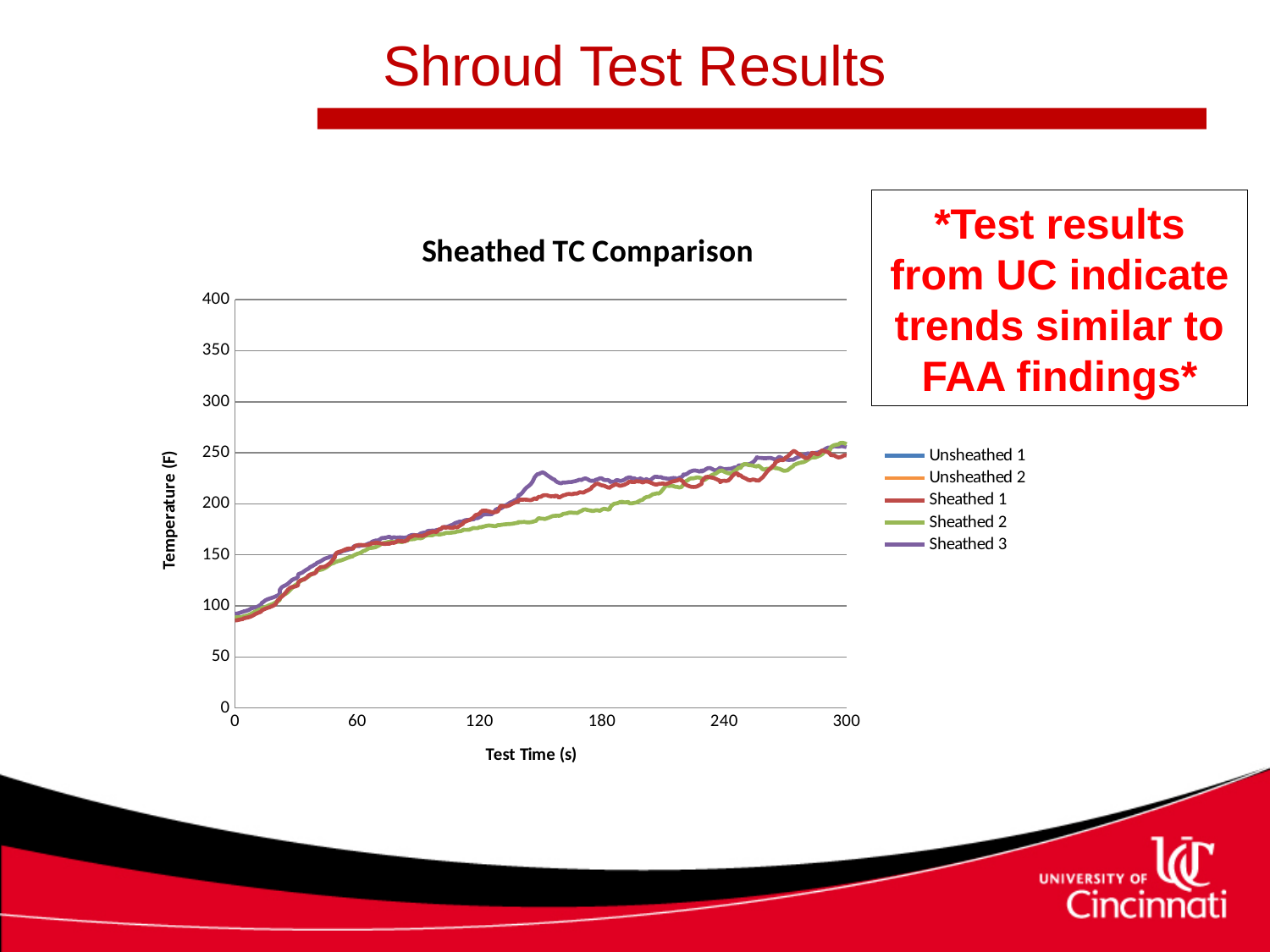
At 150 s, which is larger: Sheathed 2 or Sheathed 3? Sheathed 3 Is the value for Sheathed 3 at 150 s greater or less than 200? greater What is the title of the chart? Sheathed TC Comparison Is the value for Sheathed 1 at 120 s greater or less than 150? greater At 180 s, which is larger: Sheathed 3 or Sheathed 2? Sheathed 3 What kind of chart is shown on the slide? line chart What is the label of the y axis? Temperature (F) How many series does the chart's legend list? 5 Do the temperature values generally rise or fall as test time increases? rise Is the value for Sheathed 2 at 300 s greater or less than 200? greater